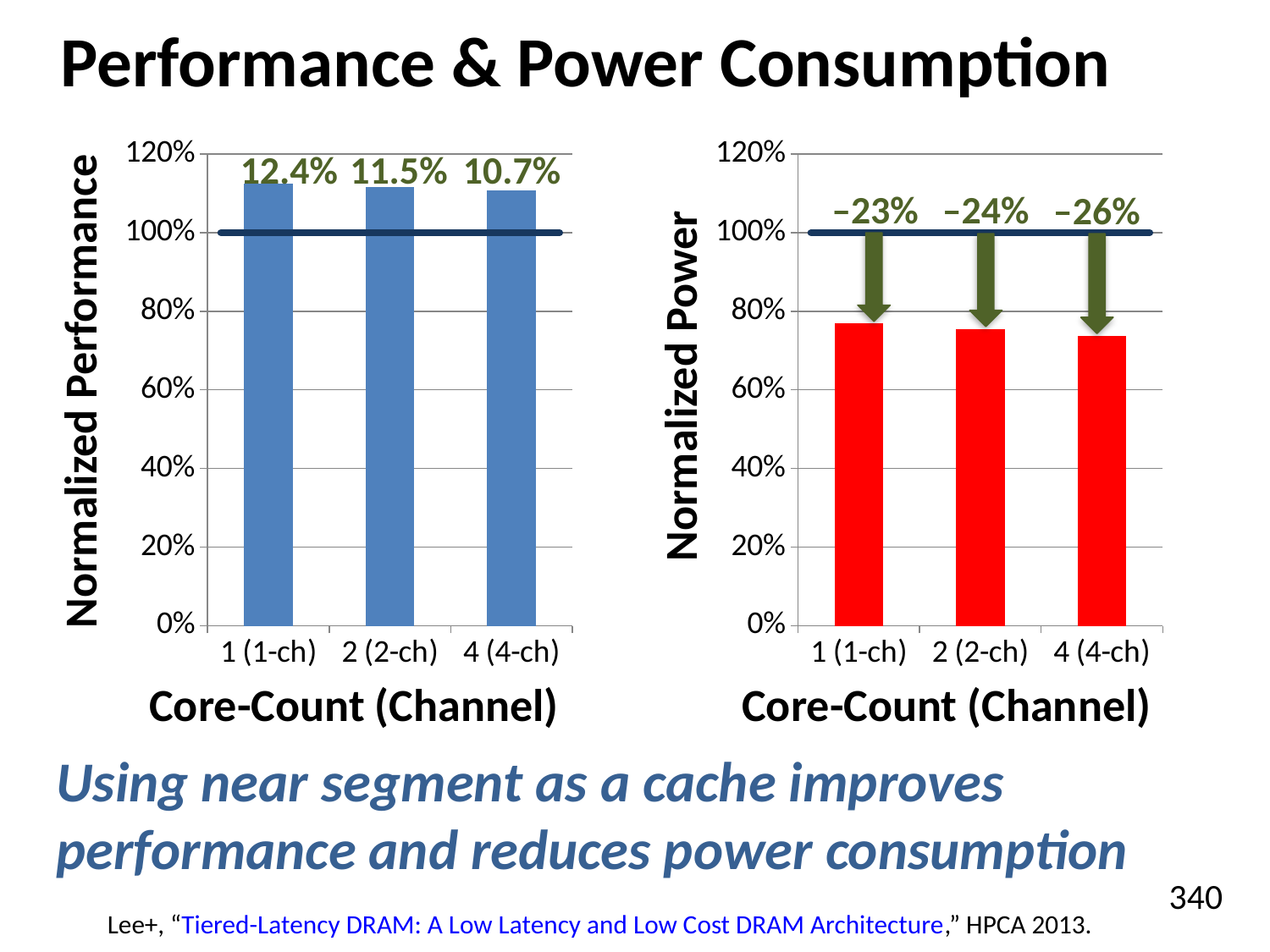
In the Normalized Power chart (right), what percentage label is printed above the 4 (4-ch) bar? –26% What is the x-axis title of the Normalized Performance chart (left)? Core-Count (Channel) In the Normalized Power chart (right), do the bar values rise or fall as the core count increases from 1 (1-ch) to 4 (4-ch)? fall In the Normalized Power chart (right), which core-count category has the lowest bar? 4 (4-ch) In the Normalized Performance chart (left), what percentage label is printed above the 4 (4-ch) bar? 10.7% In the Normalized Performance chart (left), what percentage label is printed above the 1 (1-ch) bar? 12.4% In the Normalized Performance chart (left), is the value for 2 (2-ch) greater or less than 100%? greater In the Normalized Performance chart (left), which core-count category has the highest bar? 1 (1-ch) How many core-count categories are shown on the x axis of the Normalized Power chart (right)? 3 In the Normalized Power chart (right), is the value for 1 (1-ch) greater or less than 80%? less In the Normalized Power chart (right), what percentage label is printed above the 2 (2-ch) bar? –24% What kind of chart is the Normalized Performance chart (left)? bar chart